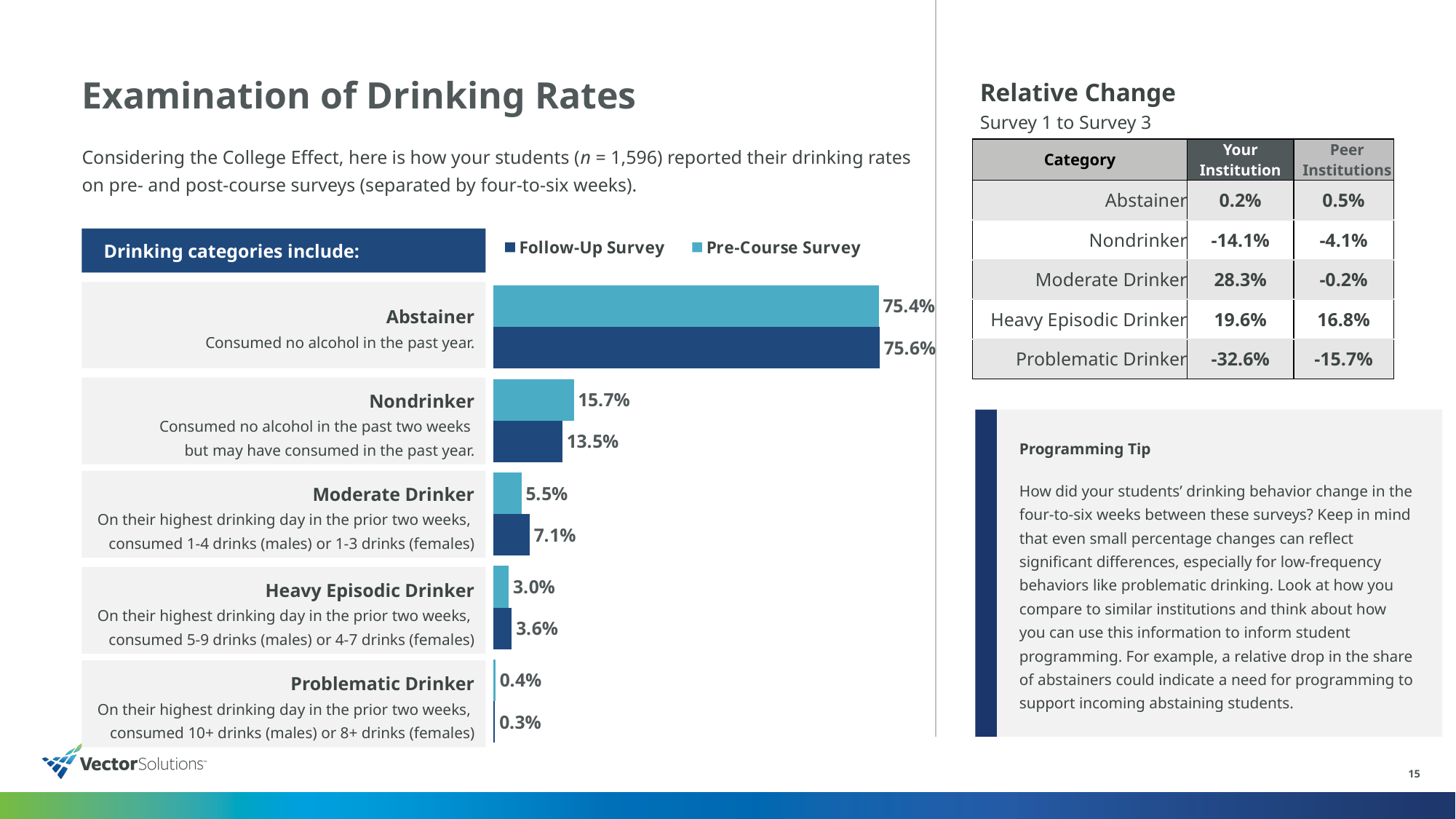
How many series does the chart legend list? 2 What is the Pre-Course Survey value for Problematic Drinker? 0.4% Which category has the highest Pre-Course Survey value? Abstainer Which is larger for Heavy Episodic Drinker, the Pre-Course Survey value or the Follow-Up Survey value? Follow-Up Survey What is the difference between the Pre-Course Survey and Follow-Up Survey values for Nondrinker? 2.2% How many drinking categories are shown in the chart? 5 What is the difference between the Follow-Up Survey and Pre-Course Survey values for Moderate Drinker? 1.6% What is the Follow-Up Survey value for Abstainer? 75.6% What is the Pre-Course Survey value for Nondrinker? 15.7% What kind of chart is used to show the drinking rates? Bar chart Which category has the lowest Follow-Up Survey value? Problematic Drinker What is the Follow-Up Survey value for Moderate Drinker? 7.1%